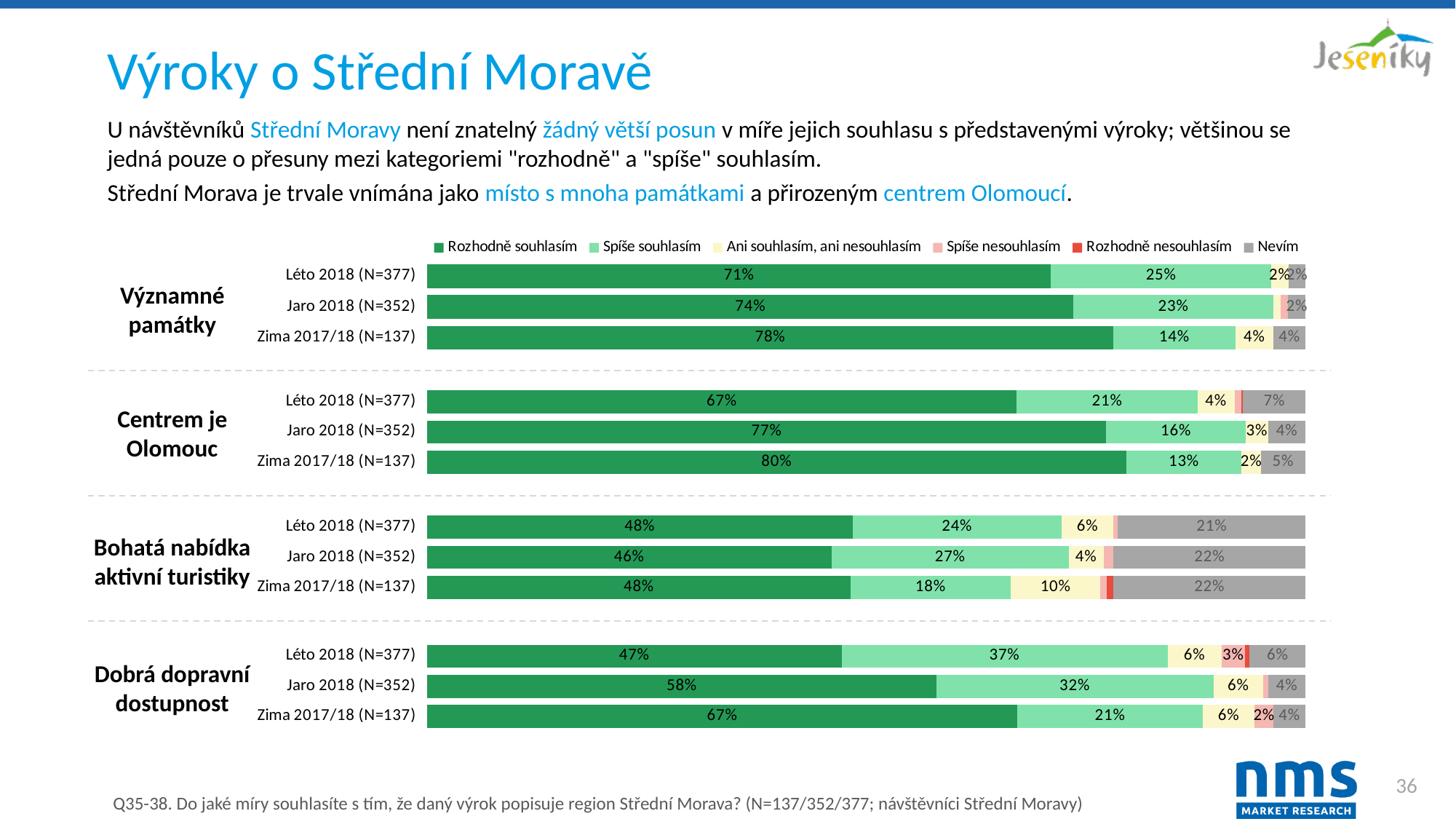
For "Významné památky", which wave has the lowest "Rozhodně souhlasím" share? Léto 2018 (N=377) What is the "Nevím" share for "Bohatá nabídka aktivní turistiky" in Jaro 2018 (N=352)? 22% What is the "Ani souhlasím, ani nesouhlasím" value for "Bohatá nabídka aktivní turistiky" in Zima 2017/18 (N=137)? 10% What percentage of respondents in Zima 2017/18 (N=137) answered "Rozhodně souhlasím" to the statement "Centrem je Olomouc"? 80% How many response categories does the legend list? 6 For "Bohatá nabídka aktivní turistiky", which wave has the larger "Spíše souhlasím" share: Jaro 2018 or Zima 2017/18? Jaro 2018 What is the "Spíše souhlasím" value for "Dobrá dopravní dostupnost" in Léto 2018 (N=377)? 37% For "Dobrá dopravní dostupnost", how many percentage points higher is the "Rozhodně souhlasím" share in Jaro 2018 than in Léto 2018? 11 percentage points How many statements (groups of bars) are shown in the chart? 4 For "Dobrá dopravní dostupnost", which wave has the highest "Rozhodně souhlasím" share? Zima 2017/18 (N=137) For "Dobrá dopravní dostupnost", does the "Rozhodně souhlasím" share rise or fall from Zima 2017/18 through Jaro 2018 to Léto 2018? Fall What type of chart is shown on the slide? Stacked bar chart